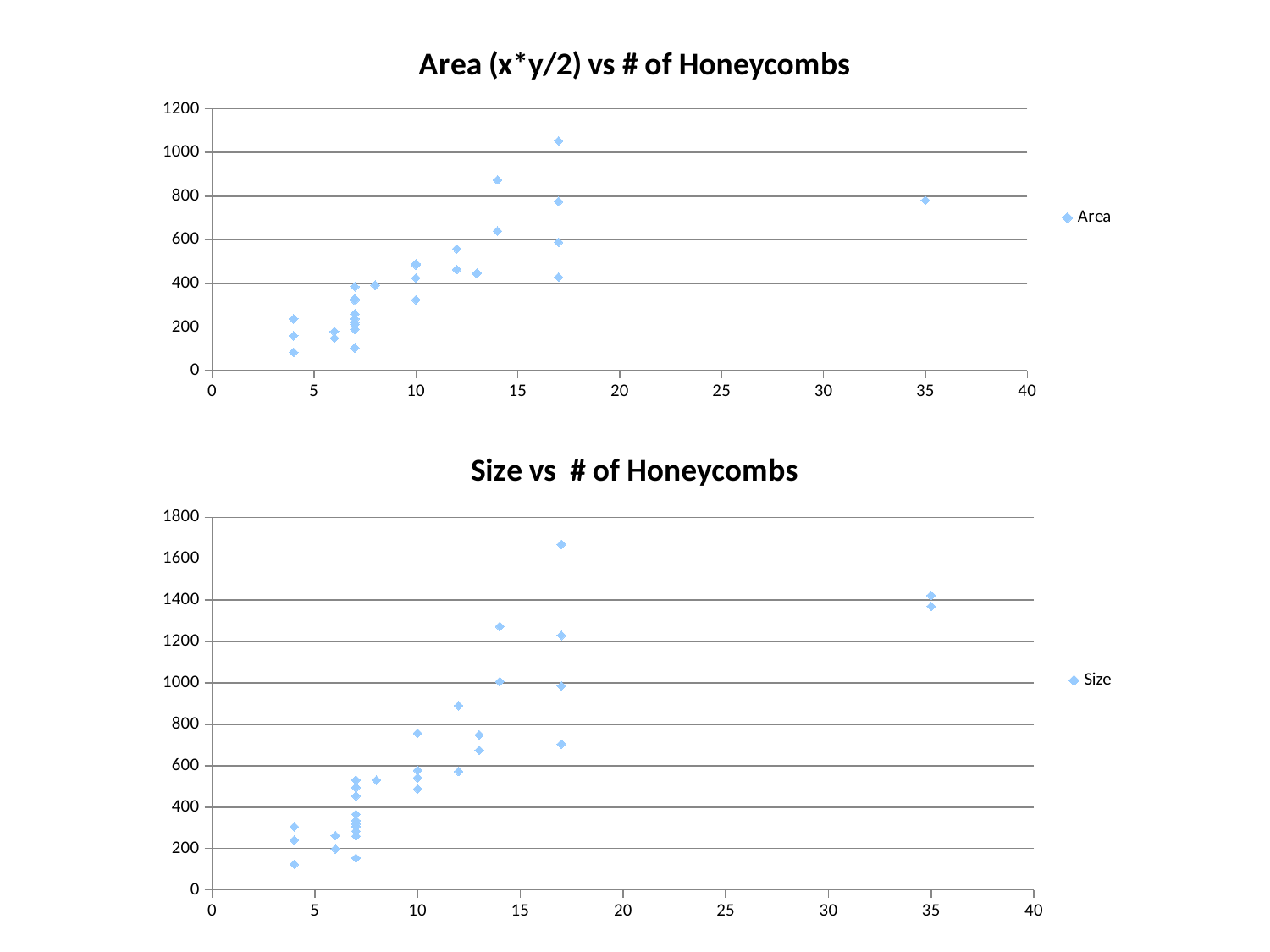
What is the legend entry of the bottom chart? Size What kind of chart is the top chart titled "Area (x*y/2) vs # of Honeycombs"? scatter chart What kind of chart is the bottom chart titled "Size vs # of Honeycombs"? scatter chart In the top chart, is the Area value for the point at x = 35 greater or less than 600? greater In the top chart, do the Area values generally rise or fall as the number of honeycombs increases along the x axis? rise In the top chart, is the highest Area value at x = 17 greater or less than 1000? greater How many series does the legend of the top chart list? 1 In the bottom chart, is the highest Size value at x = 17 greater or less than 1600? greater In the bottom chart, do the Size values generally rise or fall as the number of honeycombs increases along the x axis? rise What is the title of the top chart? Area (x*y/2) vs # of Honeycombs